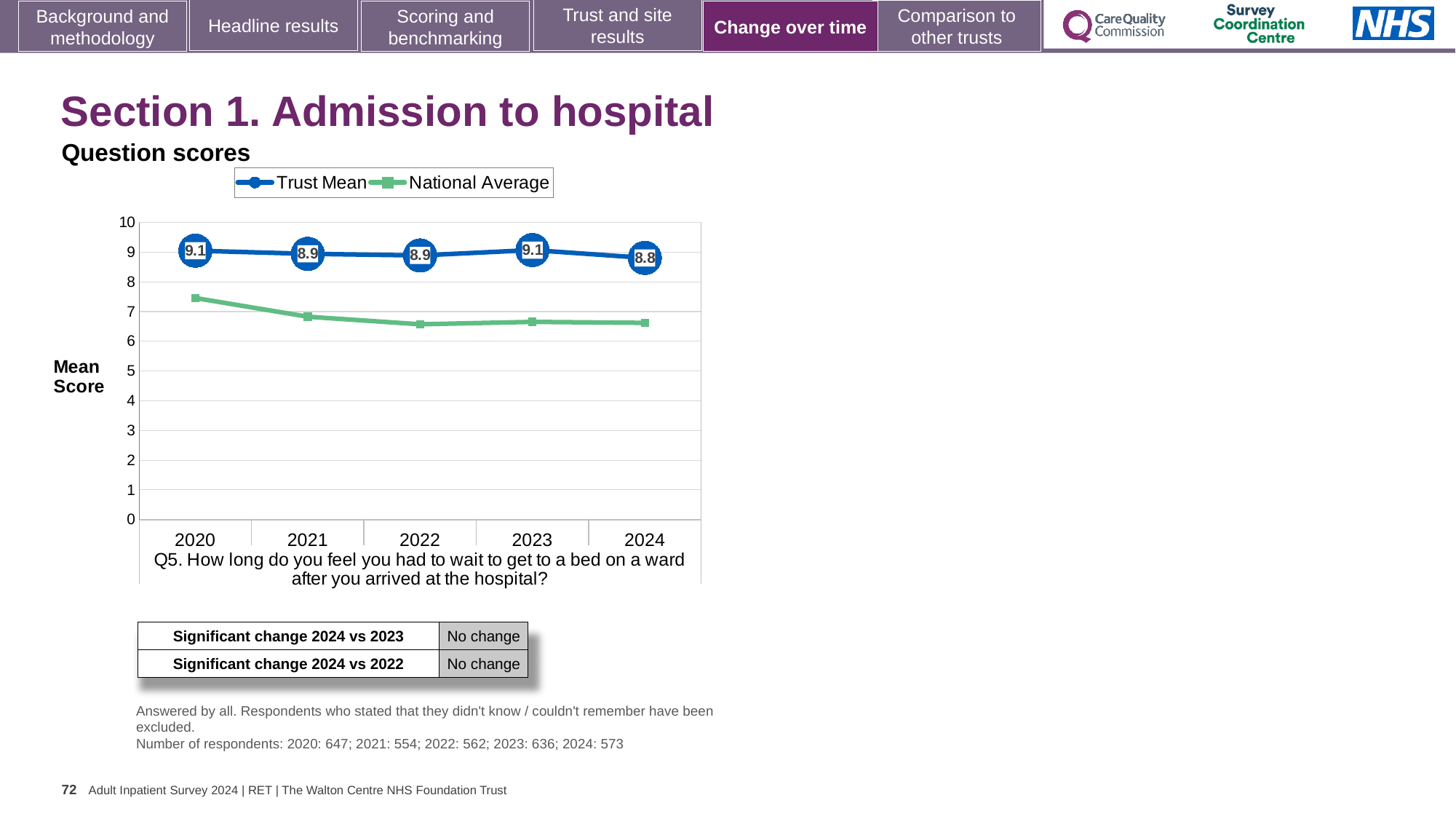
How many series does the chart legend list? 2 What is the Trust Mean score for 2022? 8.9 Is the National Average value for 2022 greater or less than 7? less How many years are shown on the x axis of the chart? 5 Does the National Average line rise or fall from 2020 to 2024? Fall Is the National Average value for 2020 greater or less than 7? greater What is the Trust Mean score for 2024? 8.8 What kind of chart is shown on the slide? Line chart In 2024, which is higher: the Trust Mean or the National Average? Trust Mean What is the Trust Mean score for 2020? 9.1 In which year is the Trust Mean score lowest? 2024 What is the difference between the Trust Mean score in 2020 and in 2024? 0.3